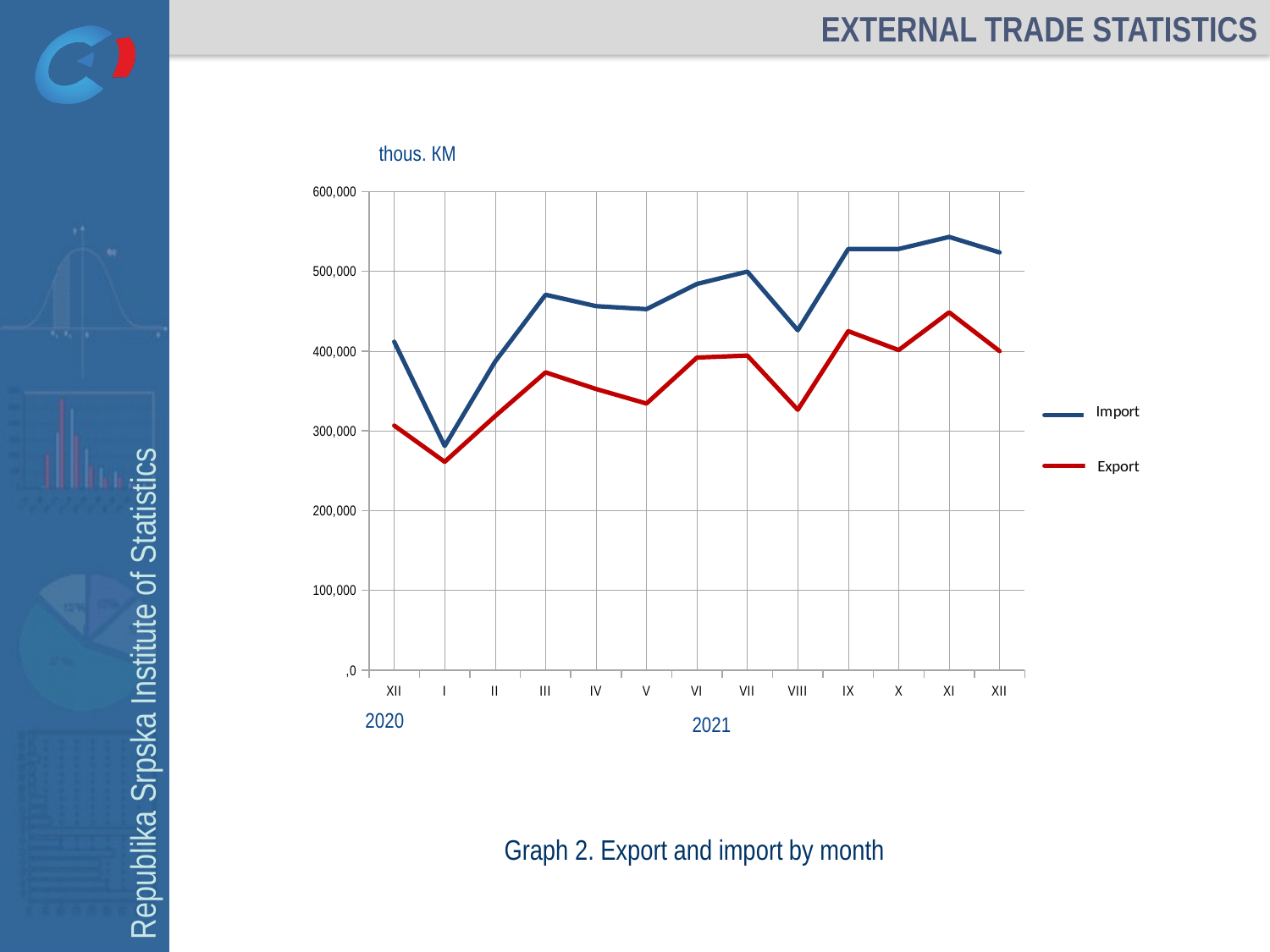
How many monthly data points are plotted along the x axis? 13 In which month is the Import value lowest? I (2021) What type of chart is shown on the slide? Line chart How many series does the legend list? 2 In which month is the Export value lowest? I (2021) Is the Export value for XI 2021 greater or less than 400,000? greater Is the Import value for I 2021 greater or less than 300,000? less In which month is the Export value highest? XI (2021) Is the Import value for XI 2021 greater or less than 500,000? greater In which unit are the values expressed, according to the label above the chart? thous. KM Which two series are shown in the legend? Import and Export Which is larger in VII 2021, Import or Export? Import